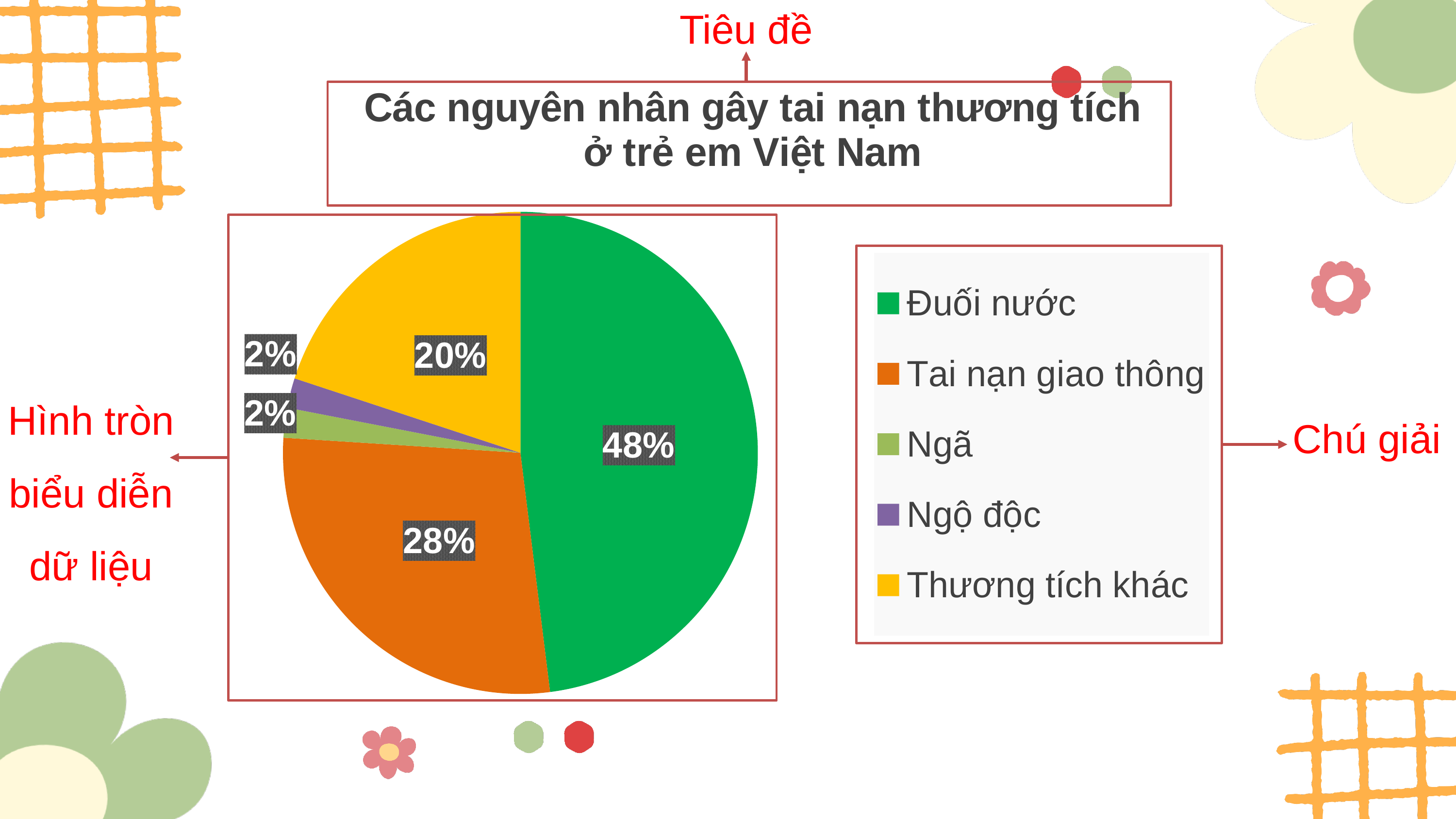
What colour represents Thương tích khác in the pie chart? Yellow How many categories does the legend list? 5 What percentage of the pie is Tai nạn giao thông? 28% What percentage of the pie is Đuối nước? 48% What percentage of the pie is Ngộ độc? 2% Which category has the largest share of the pie? Đuối nước What percentage of the pie is Thương tích khác? 20% What is the title of the chart? Các nguyên nhân gây tai nạn thương tích ở trẻ em Việt Nam What type of chart is shown on the slide? Pie chart What is the difference between the shares of Đuối nước and Tai nạn giao thông? 20% Which is larger, the share of Tai nạn giao thông or the share of Thương tích khác? Tai nạn giao thông What is the combined share of Ngã and Ngộ độc? 4%